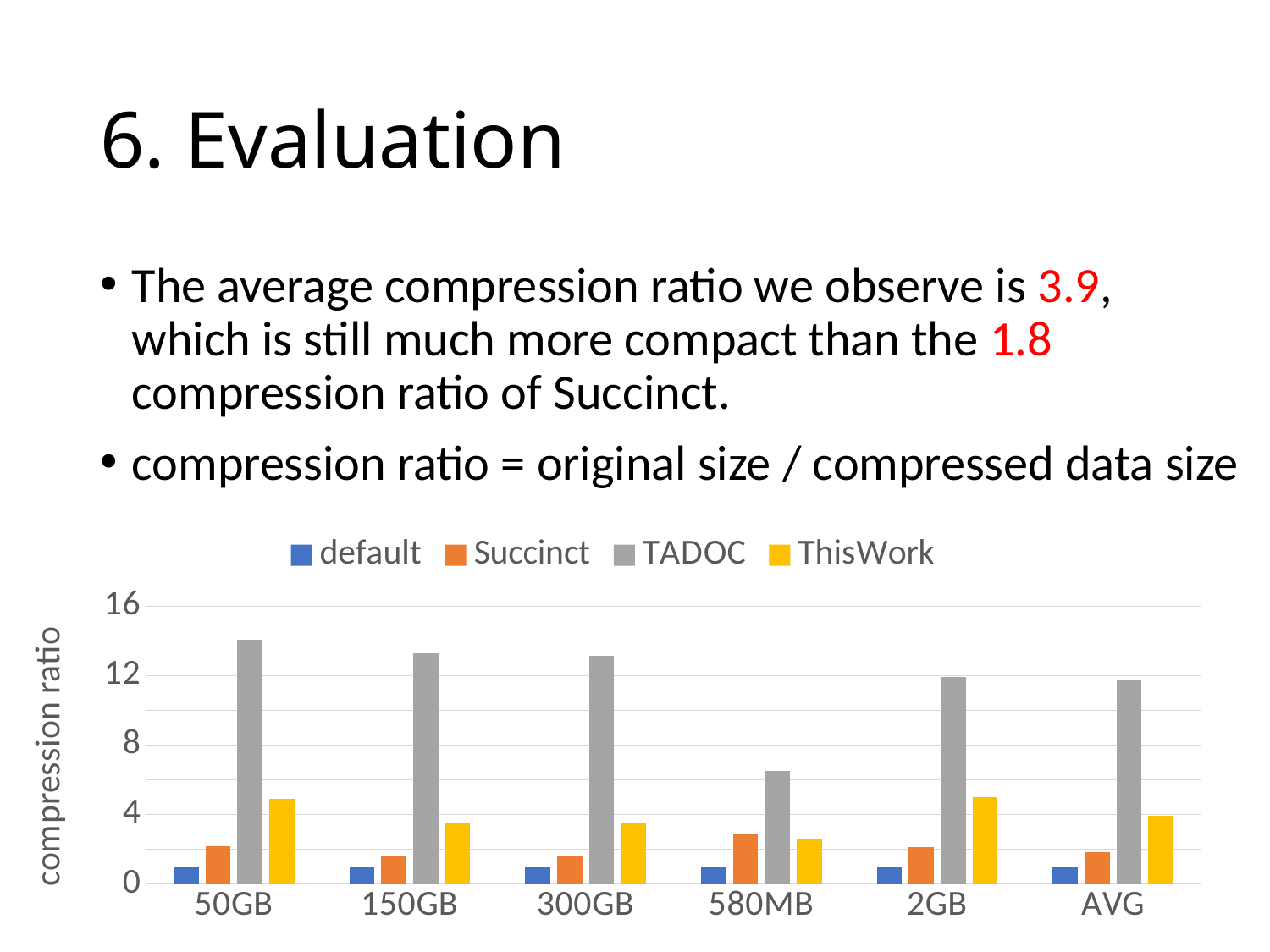
Which series has the highest bar in the 50GB category? TADOC Which is larger in the 50GB category, the ThisWork bar or the Succinct bar? ThisWork For the TADOC series, which category has the lowest bar? 580MB Is the TADOC value for 50GB greater or less than 12? greater Is the ThisWork value for 580MB greater or less than 4? less How many series does the legend list? 4 What is the label on the vertical axis of the chart? compression ratio Is the TADOC value for 580MB greater or less than 8? less Which is larger for the TADOC series, the 50GB bar or the 580MB bar? 50GB What kind of chart is shown on the slide? bar chart How many categories are shown on the x axis? 6 Which series has the lowest bar in the AVG category? default